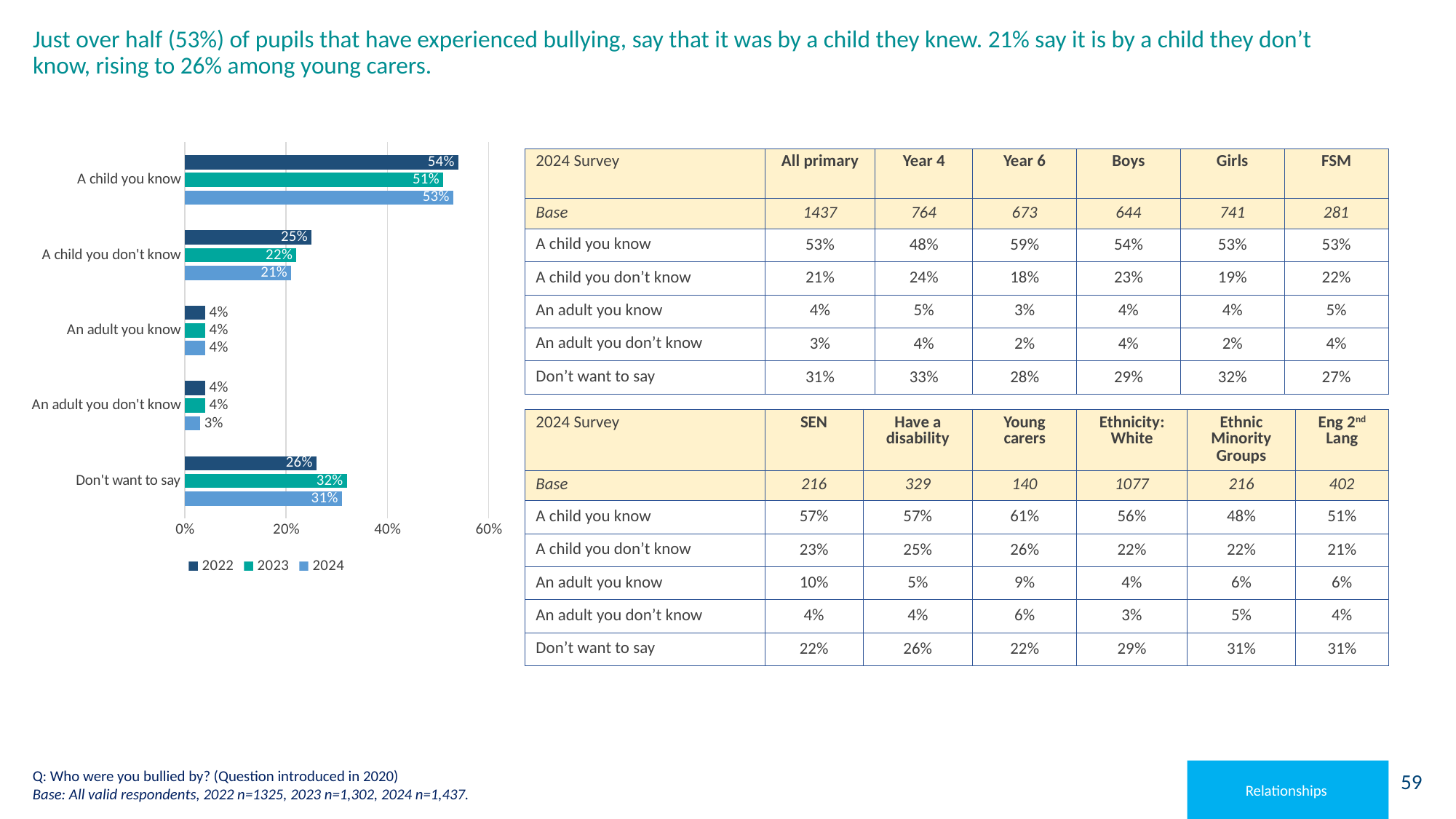
Which category has the highest value in the 2022 series? A child you know What is the 2024 value for 'A child you know'? 53% What kind of chart is shown on the slide? Bar chart What is the 2022 value for 'A child you don't know'? 25% What is the 2024 value for 'An adult you don't know'? 3% What is the difference between the 2022 and 2023 values for 'A child you know'? 3% Which is larger: the 2023 value for 'Don't want to say' or the 2022 value for 'Don't want to say'? 2023 How many series does the legend list? 3 Which years are listed in the chart legend? 2022, 2023, 2024 What is the 2023 value for 'Don't want to say'? 32% What is the difference between the 2022 and 2024 values for 'A child you don't know'? 4% How many categories are shown on the chart? 5